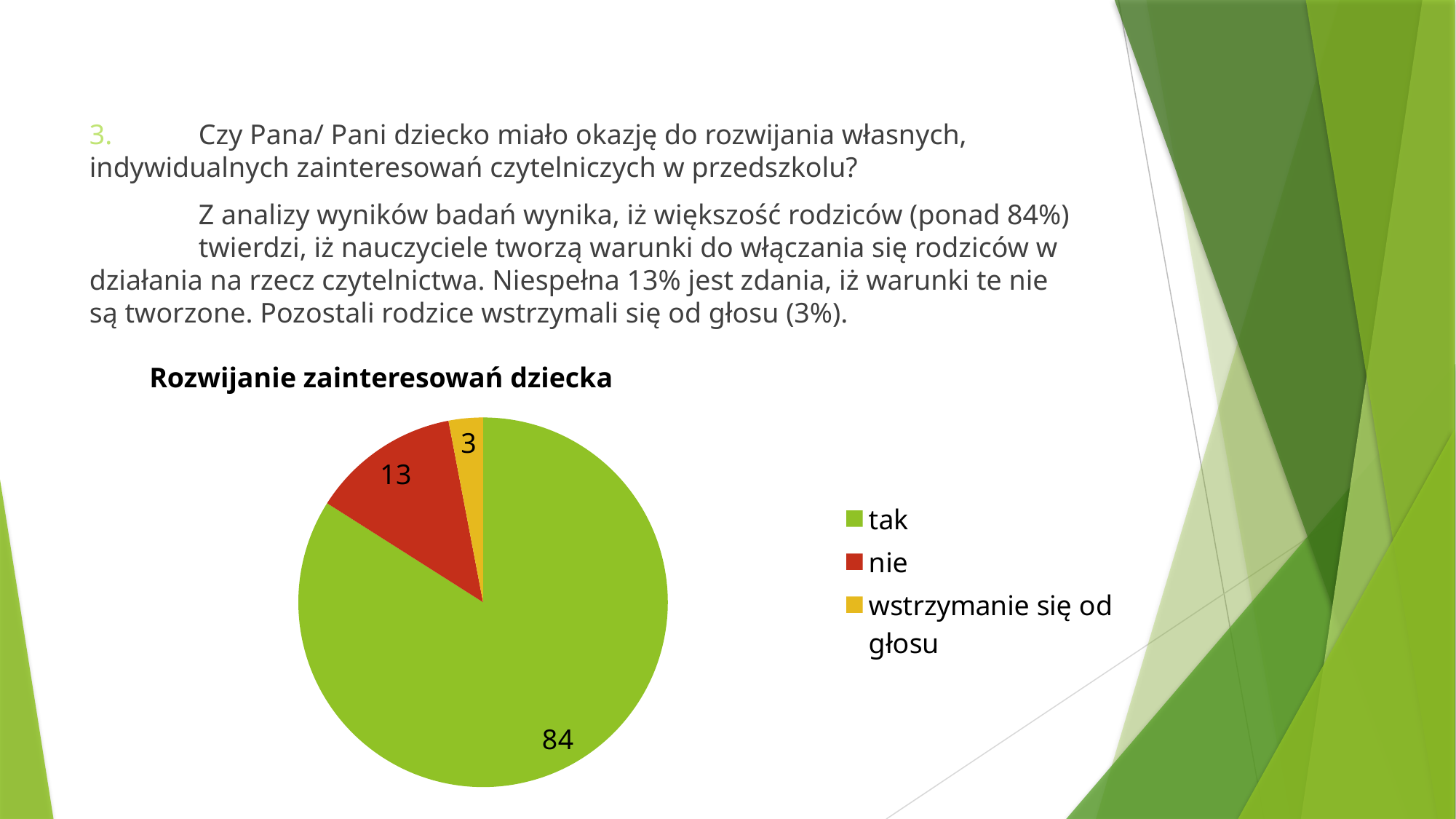
What colour is the slice for "nie"? red Which category has the smallest slice in the pie chart? wstrzymanie się od głosu What is the value for "wstrzymanie się od głosu" in the pie chart? 3 What is the title of the chart? Rozwijanie zainteresowań dziecka Which is larger, the value for "nie" or the value for "wstrzymanie się od głosu"? nie What is the difference between the values for "tak" and "nie"? 71 What is the difference between the values for "nie" and "wstrzymanie się od głosu"? 10 Which category has the largest slice in the pie chart? tak What type of chart is shown on the slide? pie chart What is the value for "tak" in the pie chart? 84 How many categories does the pie chart have? 3 What is the value for "nie" in the pie chart? 13